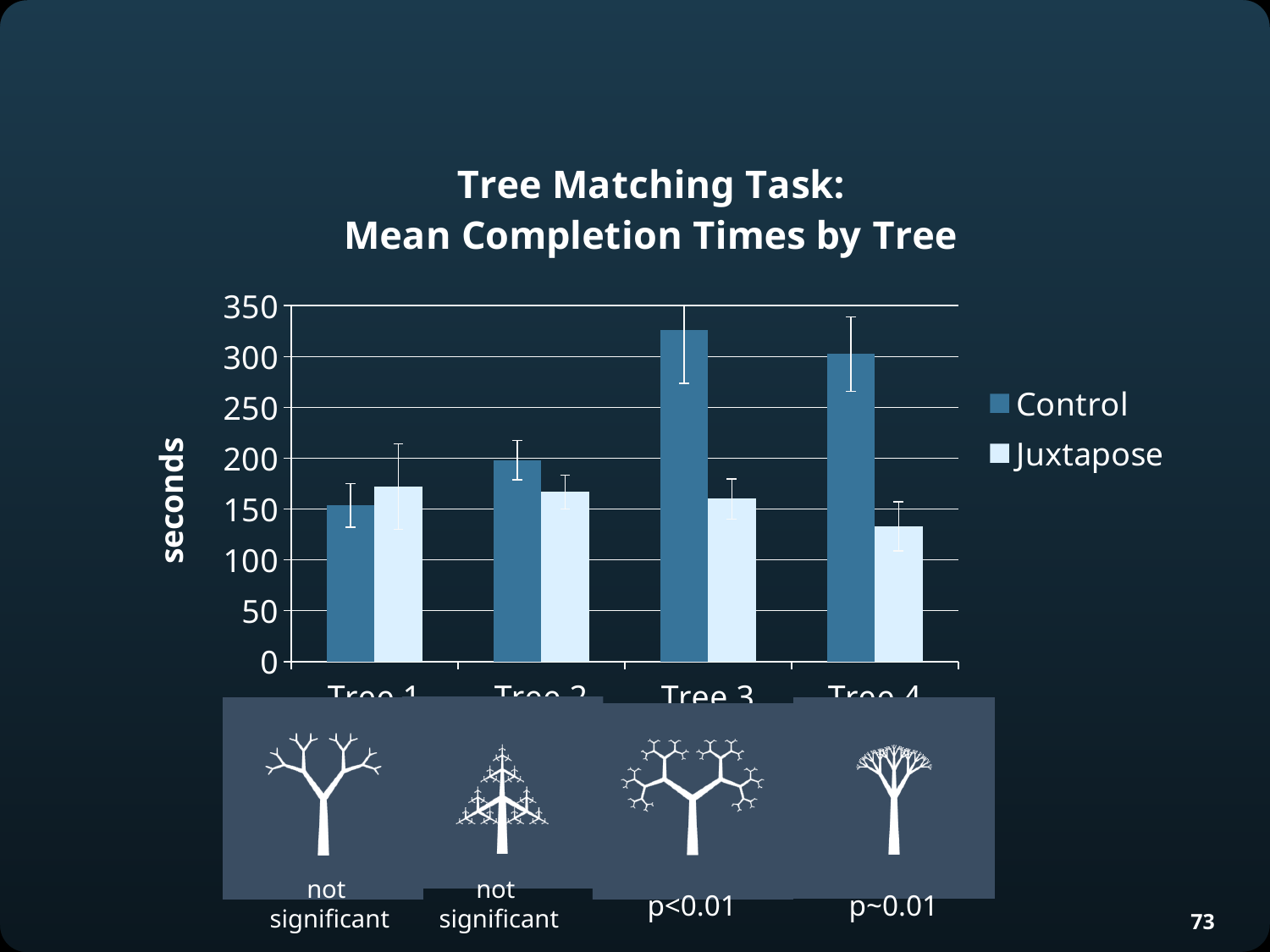
Is the Juxtapose value for Tree 4 greater or less than 150? less Which tree has the lowest Juxtapose completion time? Tree 4 What is the label on the y axis? seconds How many series does the legend list? 2 What is the title of the chart? Tree Matching Task: Mean Completion Times by Tree For Tree 1, which series has the larger value, Control or Juxtapose? Juxtapose Is the Control value for Tree 3 greater or less than 300? greater How many tree categories are plotted on the x axis? 4 For Tree 3, which series has the larger value, Control or Juxtapose? Control Is the Control value for Tree 1 greater or less than 200? less Which tree has the highest Control completion time? Tree 3 What kind of chart is shown on the slide? bar chart